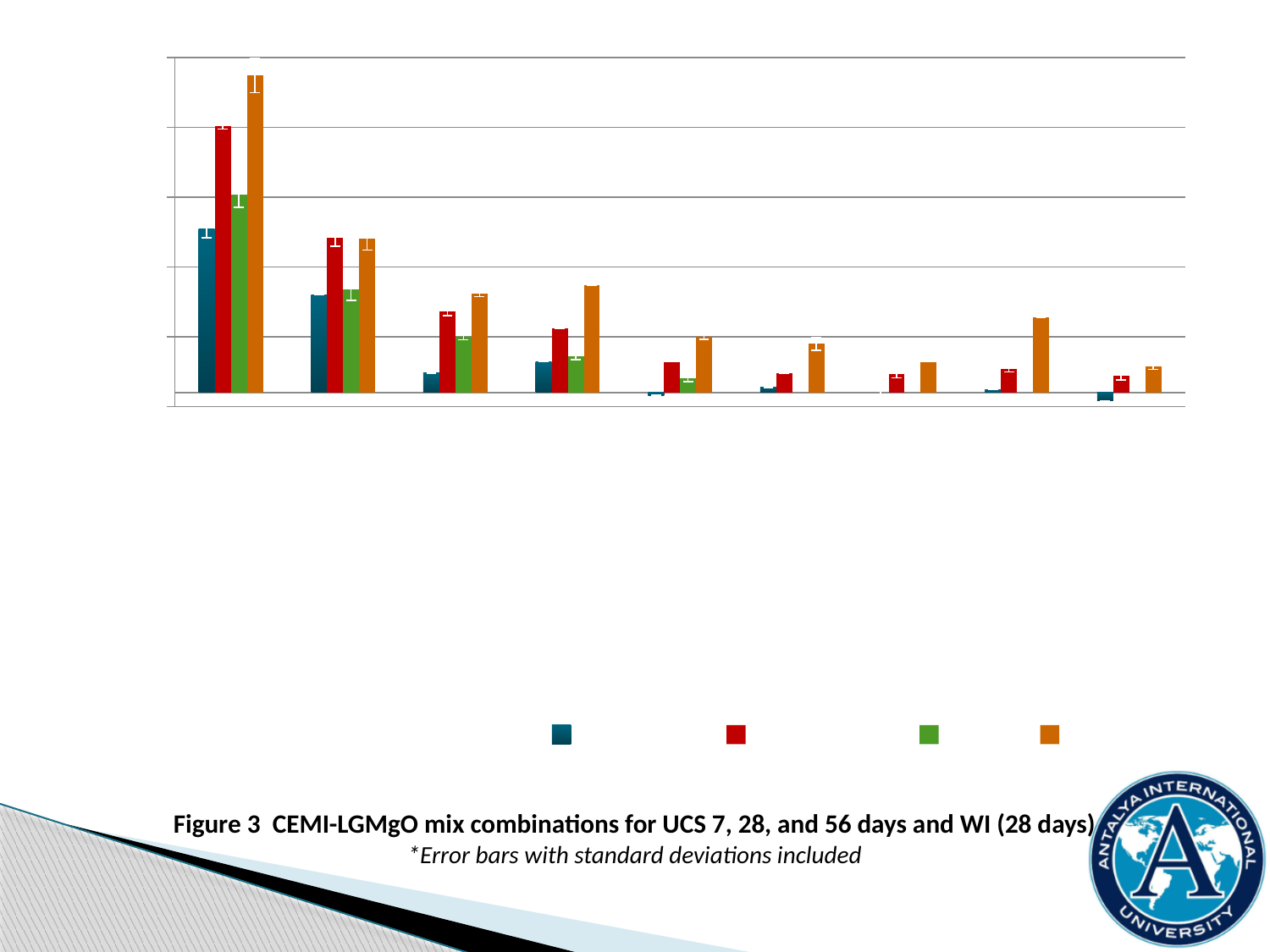
Do the bar heights generally rise or fall moving from left to right along the x axis? fall What colour is the tallest bar in the chart? orange What kind of chart is shown on the slide? bar chart According to the caption, what does Figure 3 show? CEMI-LGMgO mix combinations for UCS 7, 28, and 56 days and WI (28 days) How many series does the legend list? 4 How many groups of bars are plotted along the x axis? 9